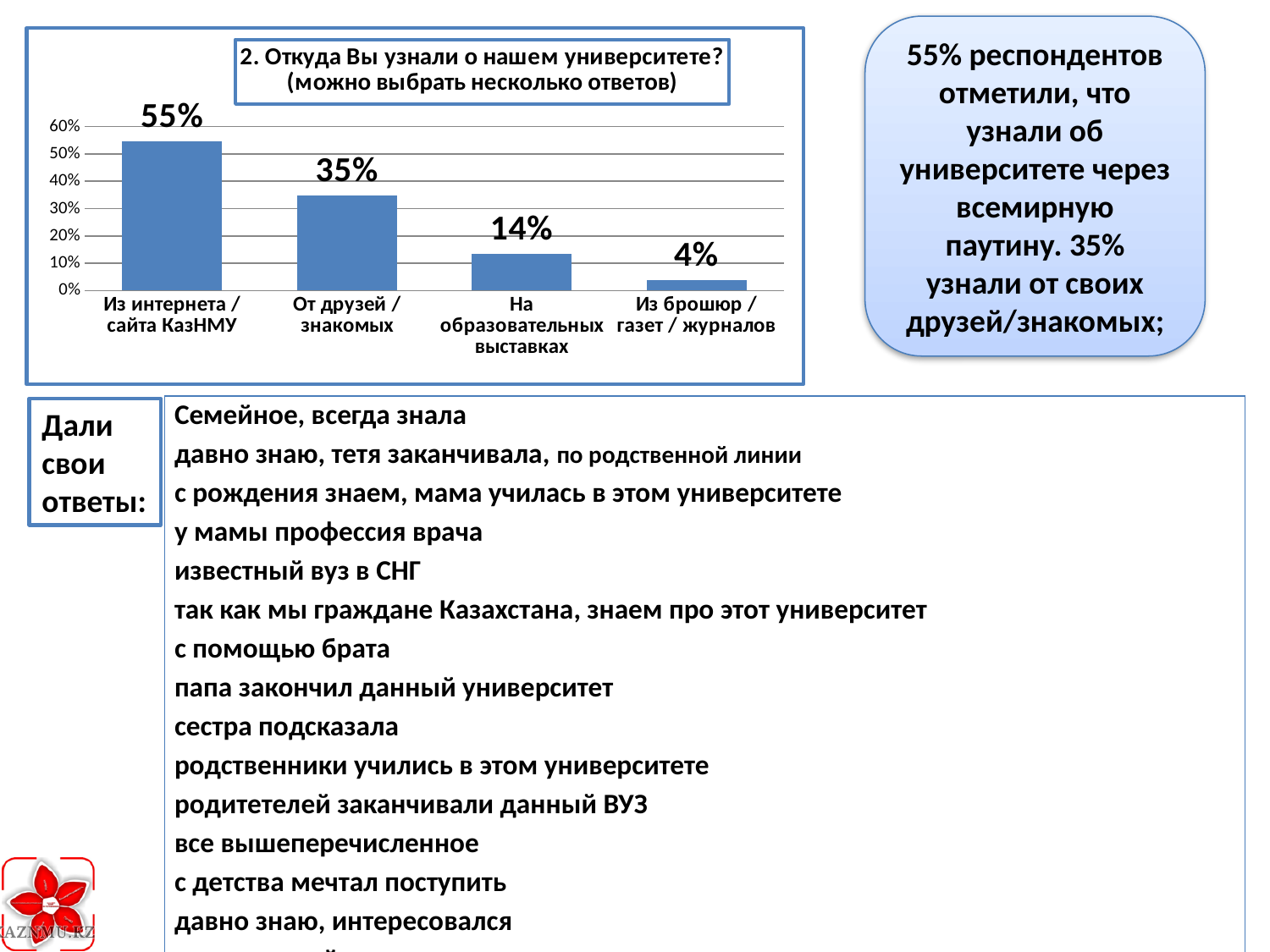
What value is shown for 'От друзей / знакомых' (from friends / acquaintances)? 35% How many categories (sources) are shown in the chart? 4 Which source has the highest percentage of respondents? Из интернета / сайта КазНМУ What value is shown for 'Из брошюр / газет / журналов' (from brochures / newspapers / magazines)? 4% Which source has the lowest percentage of respondents? Из брошюр / газет / журналов What percentage of respondents learned about the university from the internet / KazNMU website (Из интернета / сайта КазНМУ)? 55% What percentage is shown for 'На образовательных выставках' (at educational exhibitions)? 14% Is the value for 'От друзей / знакомых' greater or less than 30%? greater Which is larger: the value for 'На образовательных выставках' or for 'Из брошюр / газет / журналов'? На образовательных выставках What type of chart is shown on the slide? Bar chart What is the title of the chart? 2. Откуда Вы узнали о нашем университете? (можно выбрать несколько ответов) What is the difference in percentage points between 'Из интернета / сайта КазНМУ' and 'От друзей / знакомых'? 20 percentage points